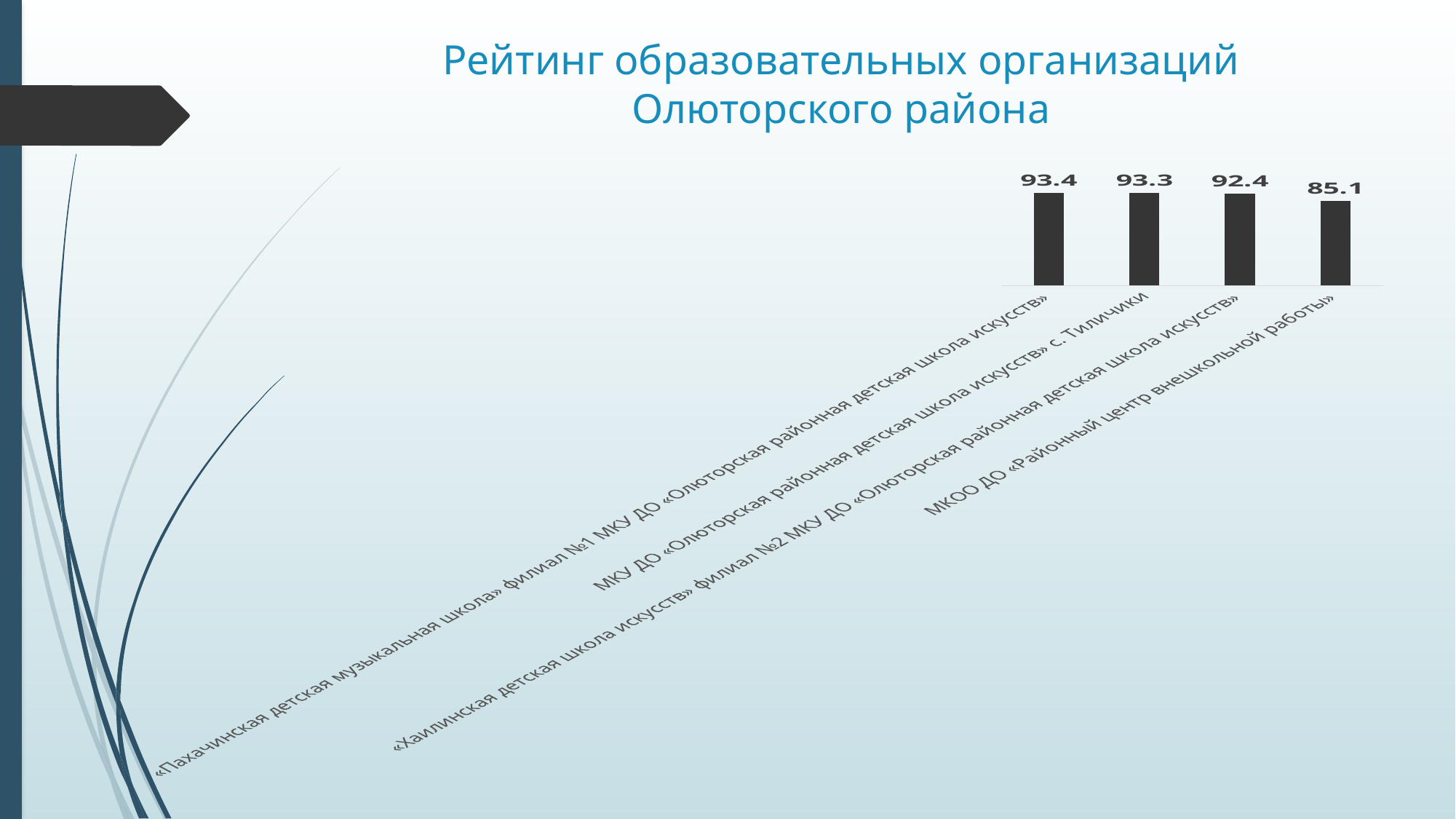
What is the value for МКУ ДО «Олюторская районная детская школа искусств» с. Тиличики? 93.3 What is the difference between the values for МКУ ДО «Олюторская районная детская школа искусств» с. Тиличики and «Хаилинская детская школа искусств» филиал №2? 0.9 Which organisation has the highest value in the chart? «Пахачинская детская музыкальная школа» филиал №1 МКУ ДО «Олюторская районная детская школа искусств» What is the value for «Хаилинская детская школа искусств» филиал №2 МКУ ДО «Олюторская районная детская школа искусств»? 92.4 What is the value for «Пахачинская детская музыкальная школа» филиал №1 МКУ ДО «Олюторская районная детская школа искусств»? 93.4 What is the value for МКОО ДО «Районный центр внешкольной работы»? 85.1 Do the values rise or fall from left to right across the chart? fall Which organisation has the lowest value in the chart? МКОО ДО «Районный центр внешкольной работы» Which has the larger value: «Хаилинская детская школа искусств» филиал №2 or МКОО ДО «Районный центр внешкольной работы»? «Хаилинская детская школа искусств» филиал №2 What type of chart is shown on the slide? bar chart How many bars (categories) does the chart show? 4 What is the difference between the values for «Пахачинская детская музыкальная школа» филиал №1 and МКОО ДО «Районный центр внешкольной работы»? 8.3